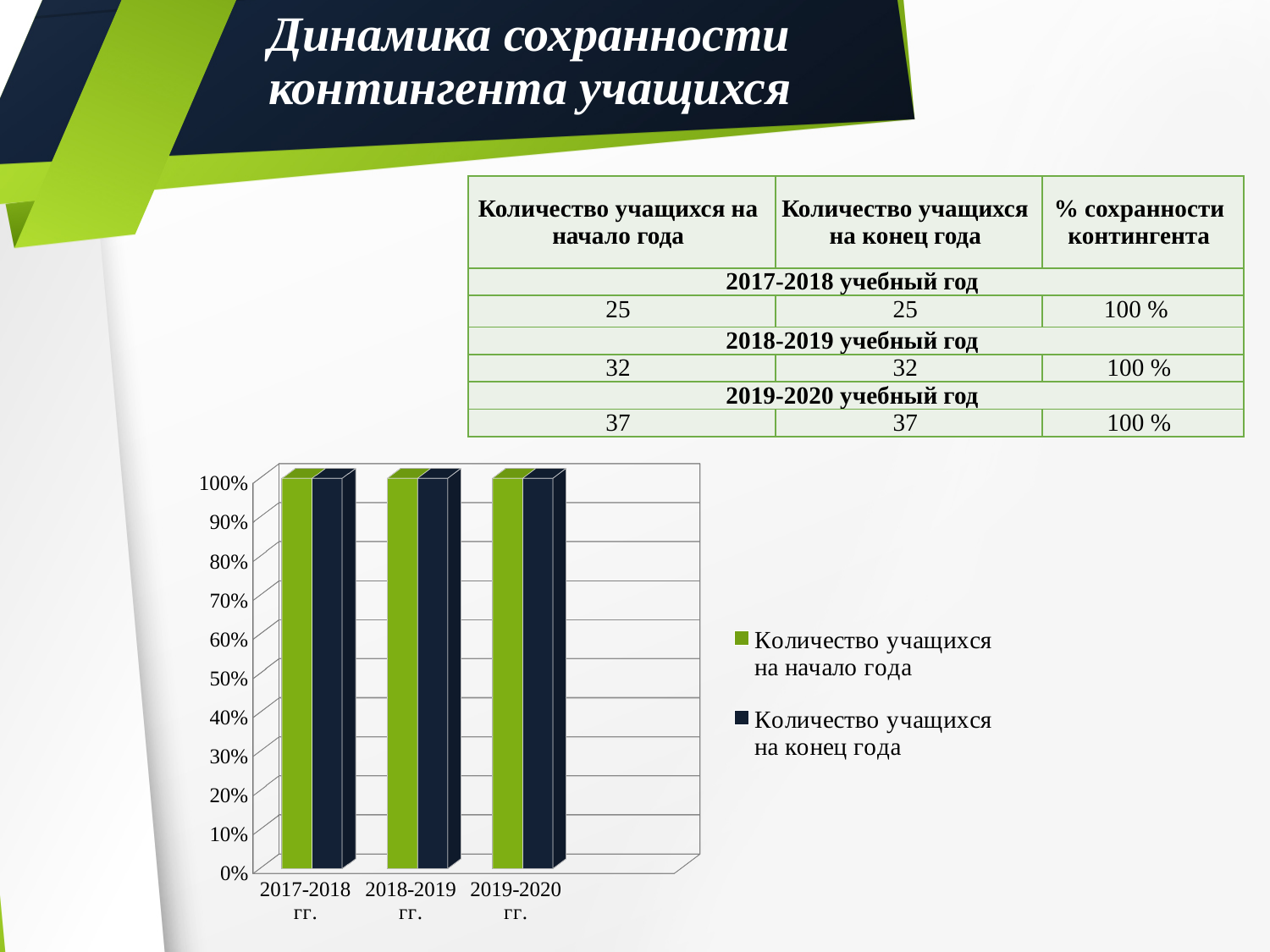
Is the value for 'Количество учащихся на конец года' in 2018-2019 гг. greater or less than 50%? greater What value does the bar for 'Количество учащихся на конец года' reach for 2019-2020 гг.? 100% What value does the bar for 'Количество учащихся на начало года' reach for 2018-2019 гг.? 100% What is the label of the first category on the x axis of the chart? 2017-2018 гг. Which series is shown in green in the chart? Количество учащихся на начало года How many categories are shown on the x axis of the chart? 3 How many series does the chart legend list? 2 What is the difference between the 'Количество учащихся на начало года' and 'Количество учащихся на конец года' bars for 2019-2020 гг.? 0% Do the values for 'Количество учащихся на начало года' rise, fall or stay the same across the years on the x axis? stay the same What value does the bar for 'Количество учащихся на начало года' reach for 2017-2018 гг.? 100% What kind of chart is shown on the slide? bar chart What is the highest tick value shown on the chart's vertical axis? 100%